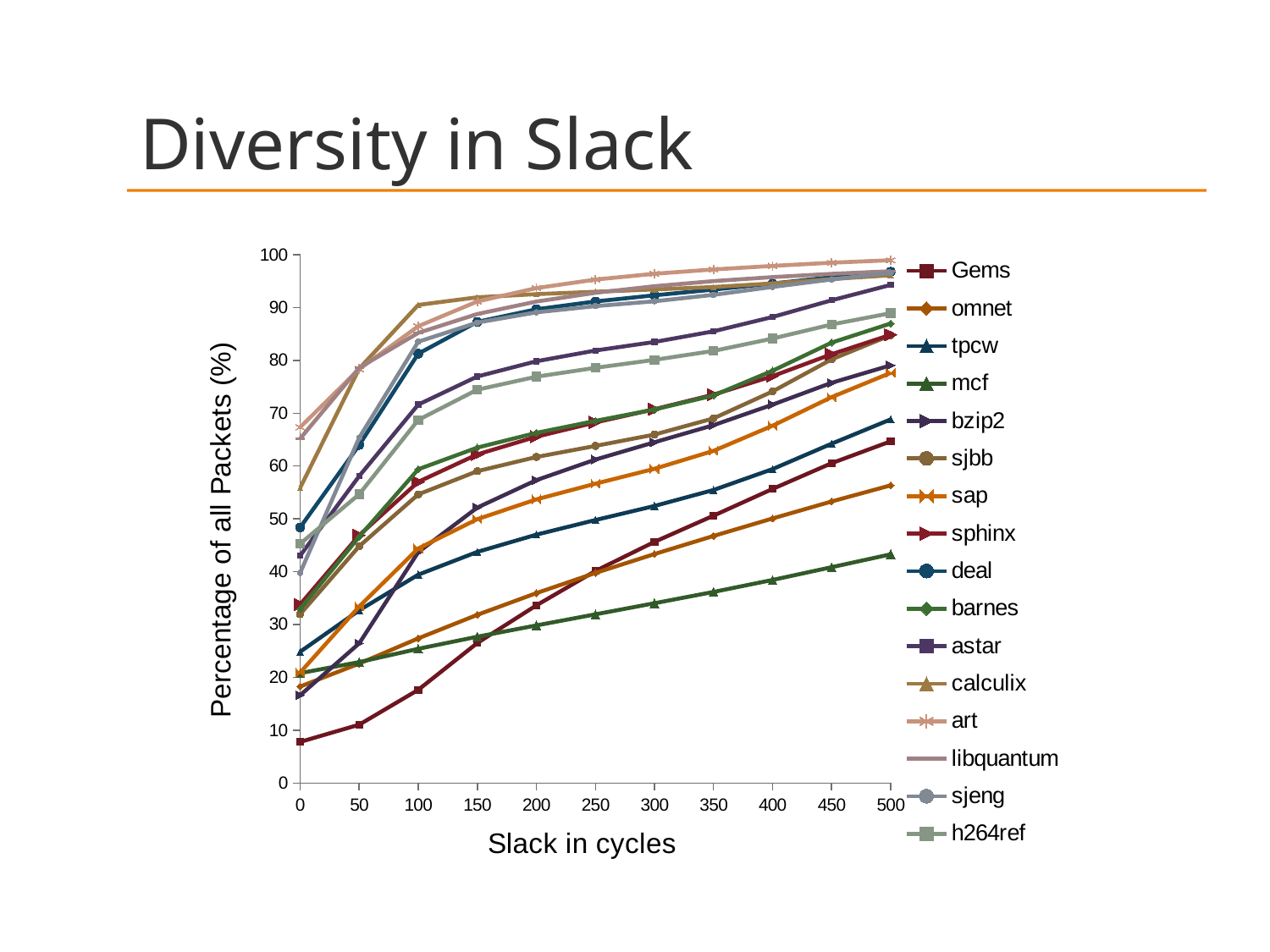
Is the value for mcf at a slack of 500 cycles greater or less than 50? less Is the value for Gems at a slack of 0 cycles greater or less than 10? less Which series has the highest percentage of packets at a slack of 500 cycles? art How many slack values (x-axis points) are plotted for each series? 11 What is the label of the y axis? Percentage of all Packets (%) Which series has the lowest percentage of packets at a slack of 500 cycles? mcf At a slack of 500 cycles, which is larger: the value for Gems or the value for mcf? Gems Do the values for Gems rise or fall as slack increases along the x axis? rise Is the value for art at a slack of 500 cycles greater or less than 90? greater What kind of chart is shown on the slide? line chart Which series has the lowest percentage of packets at a slack of 0 cycles? Gems How many series does the legend list? 16